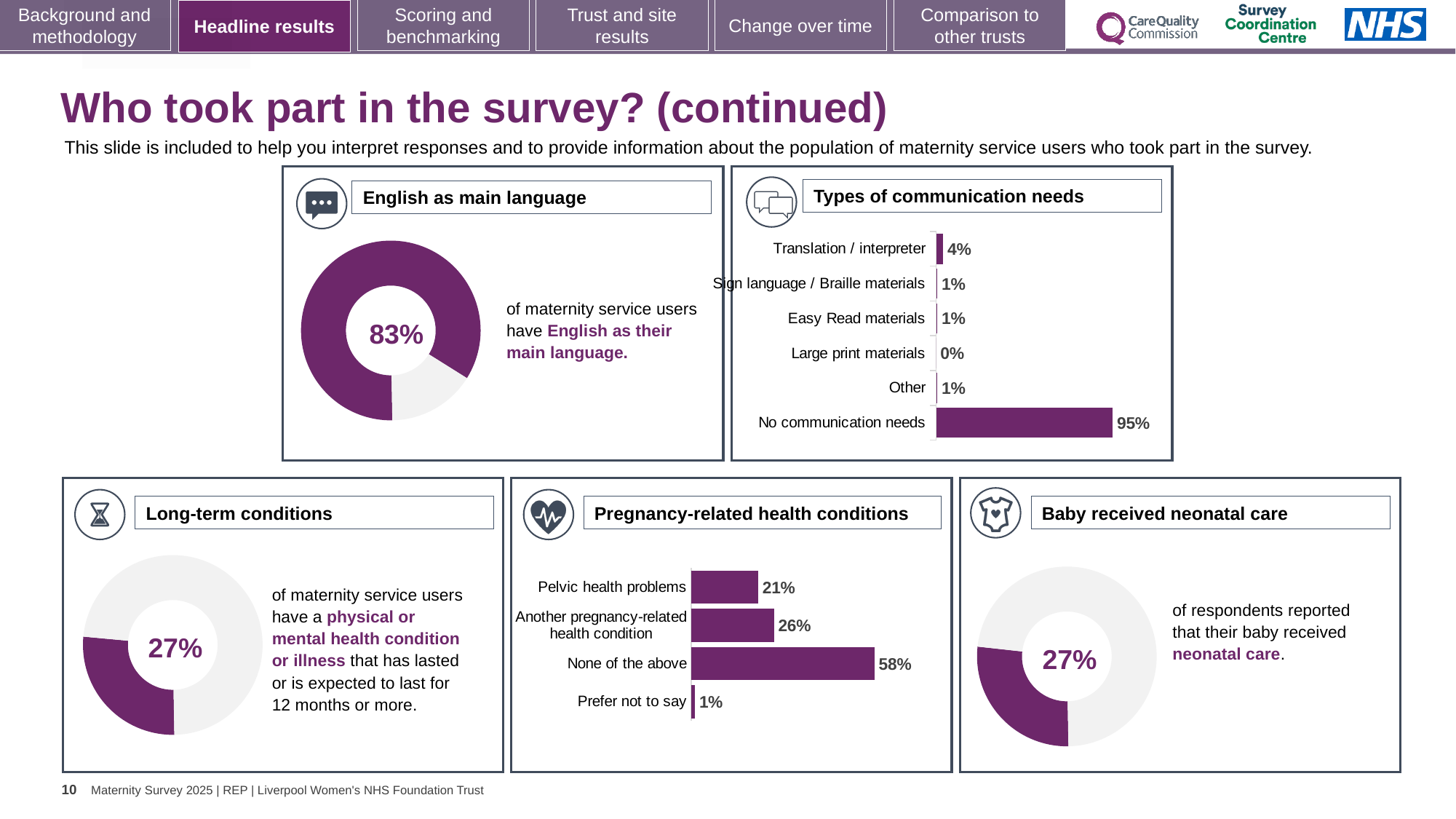
In the 'Pregnancy-related health conditions' chart, what is the difference between None of the above and Pelvic health problems? 37% What kind of chart is used in the 'Long-term conditions' panel? Donut chart In the 'Pregnancy-related health conditions' chart, which category has the lowest value? Prefer not to say In the 'Types of communication needs' chart, which category has the highest value? No communication needs In the 'Pregnancy-related health conditions' chart, what is the value for Another pregnancy-related health condition? 26% In the 'Pregnancy-related health conditions' chart, which is larger: Pelvic health problems or Another pregnancy-related health condition? Another pregnancy-related health condition In the 'Types of communication needs' chart, what is the value for Large print materials? 0% In the 'English as main language' chart, what percentage of maternity service users have English as their main language? 83% In the 'Types of communication needs' chart, what is the value for Translation / interpreter? 4% What kind of chart is used in the 'Pregnancy-related health conditions' panel? Bar chart How many categories are shown in the 'Types of communication needs' chart? 6 In the 'Baby received neonatal care' chart, what percentage of respondents reported that their baby received neonatal care? 27%